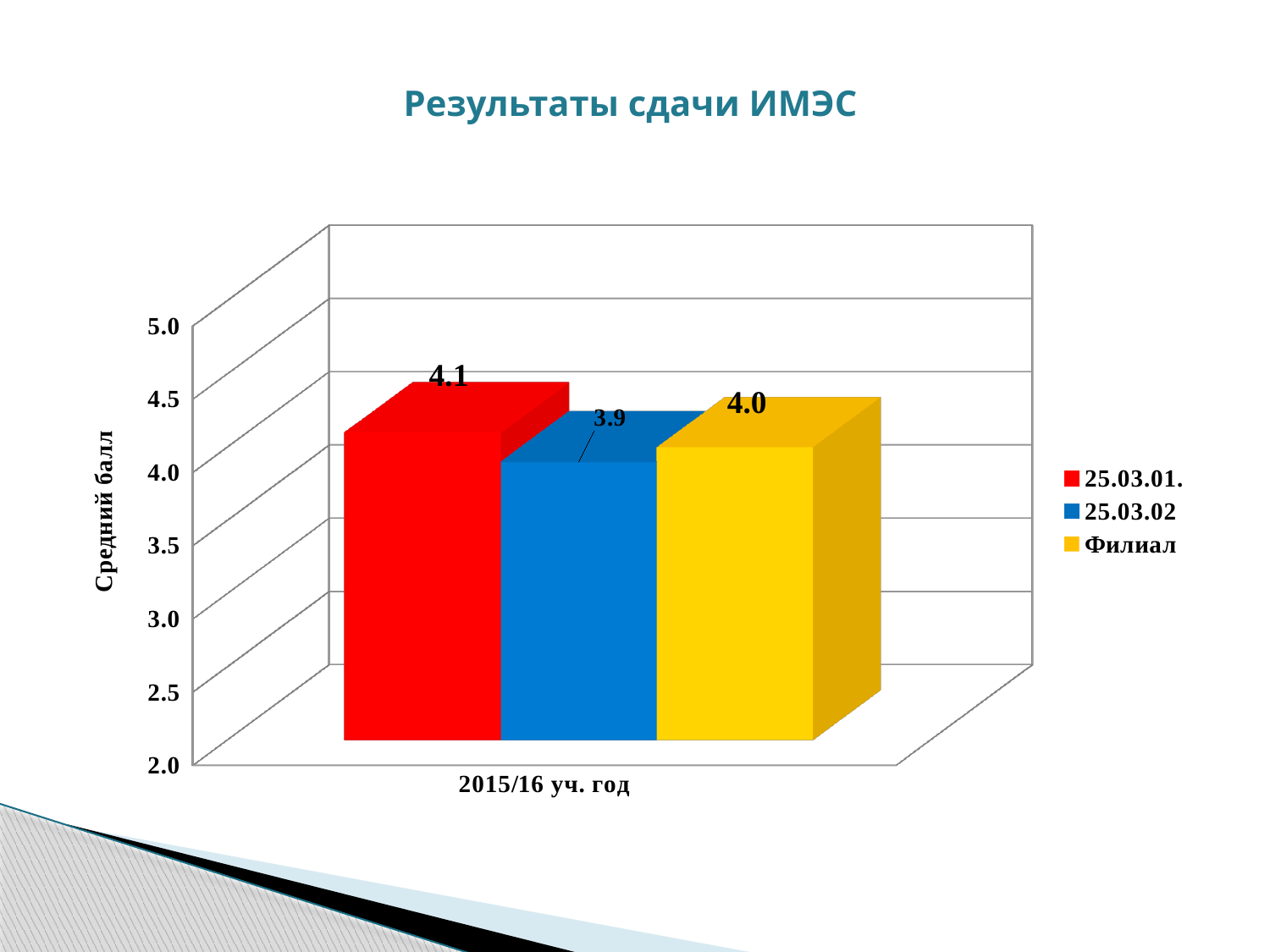
What kind of chart is shown on the slide? bar chart What is the value for Филиал in the chart? 4.0 What is the value for 25.03.01. in the chart? 4.1 What is the difference between the values for Филиал and 25.03.02? 0.1 How many series does the legend list? 3 Which series has the lowest value? 25.03.02 Which is larger, the value for 25.03.01. or the value for Филиал? 25.03.01. What is the label on the vertical axis? Средний балл Which series has the highest value? 25.03.01. What is the difference between the values for 25.03.01. and 25.03.02? 0.2 What is the value for 25.03.02 in the chart? 3.9 What is the title of the chart? Результаты сдачи ИМЭС